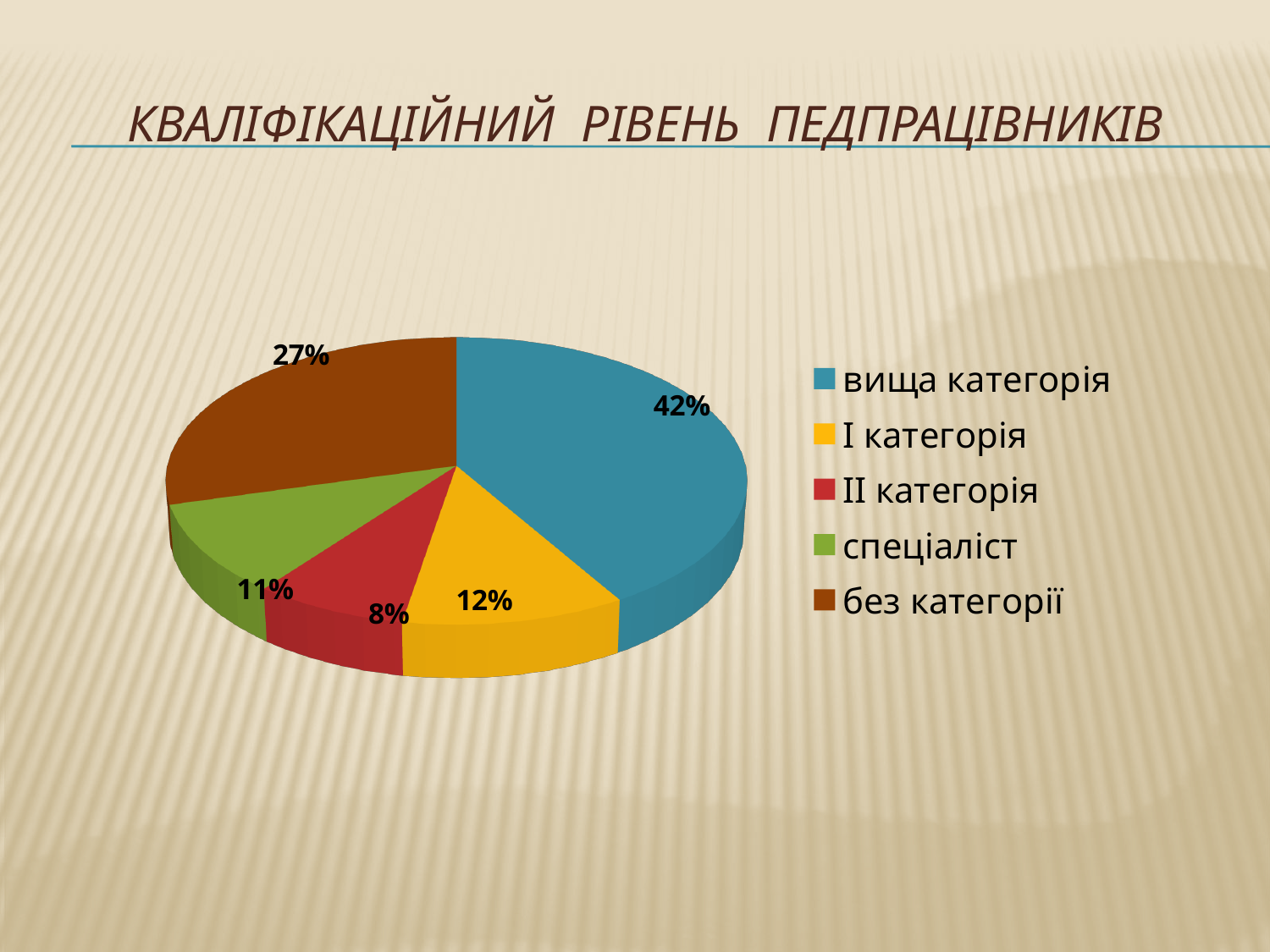
What is the value shown for 'II категорія'? 8% What kind of chart is shown on the slide? pie chart Which category has the smallest slice of the pie? II категорія What is the difference between the values for 'вища категорія' and 'без категорії'? 15% What is the value shown for 'без категорії'? 27% How many categories does the pie chart show? 5 What share of the pie does 'вища категорія' have? 42% What is the title of the slide? КВАЛІФІКАЦІЙНИЙ РІВЕНЬ ПЕДПРАЦІВНИКІВ Which category has the largest slice of the pie? вища категорія What is the value shown for 'I категорія'? 12% Which is larger, the value for 'спеціаліст' or the value for 'II категорія'? спеціаліст What is the value shown for 'спеціаліст'? 11%